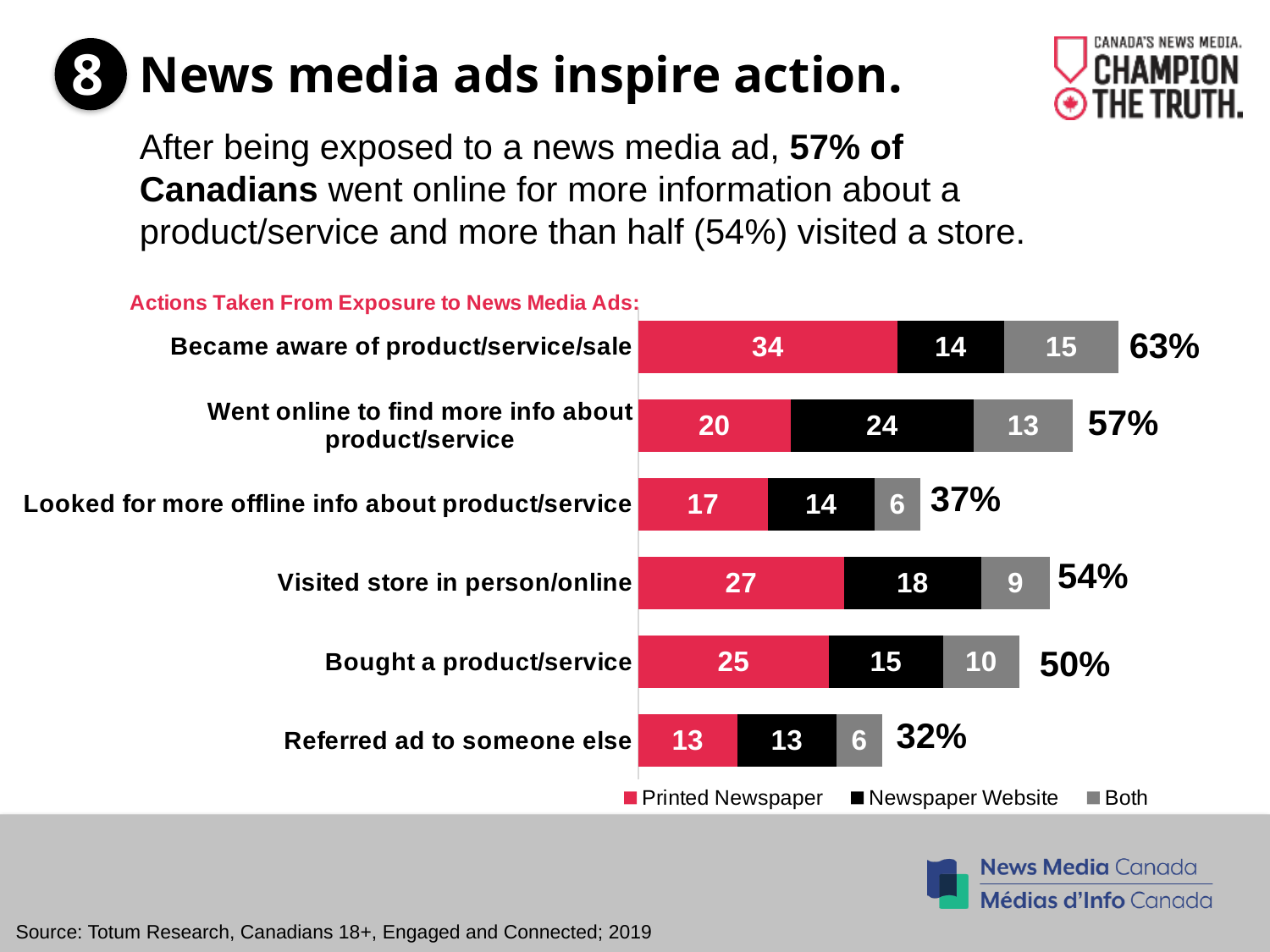
How many series does the legend list? 3 What is the Printed Newspaper value for "Became aware of product/service/sale"? 34 Which category has the highest total percentage? Became aware of product/service/sale How many categories are shown in the chart? 6 What is the Both value for "Visited store in person/online"? 9 What is the difference between the Printed Newspaper values for "Became aware of product/service/sale" and "Referred ad to someone else"? 21 Which is larger for "Went online to find more info about product/service": the Printed Newspaper value or the Newspaper Website value? Newspaper Website What is the Newspaper Website value for "Went online to find more info about product/service"? 24 Which category has the lowest total percentage? Referred ad to someone else What is the title of the chart? Actions Taken From Exposure to News Media Ads: What total percentage is shown for "Bought a product/service"? 50% What kind of chart is shown on the slide? Stacked bar chart